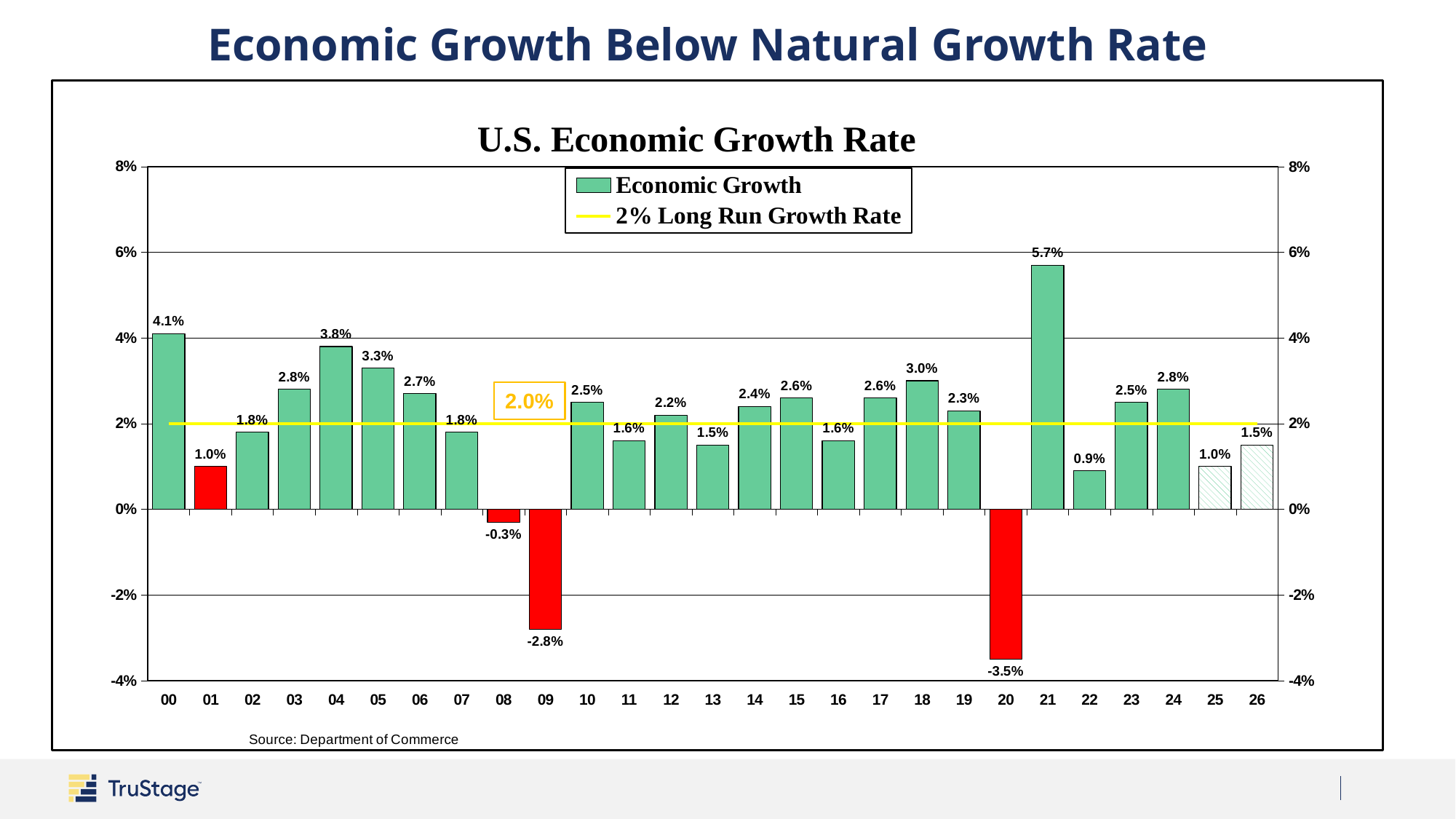
Which year has the highest economic growth rate? 21 How many entries does the legend list? 2 How many years are shown on the x axis? 27 What is the economic growth rate shown for 2026? 1.5% Which year has a higher economic growth rate, 2004 or 2018? 04 What is the difference between the economic growth rate in 2000 and in 2001? 3.1% What is the economic growth rate shown for 2009? -2.8% What kind of chart is used to show the economic growth rate? bar chart What is the economic growth rate shown for 2021? 5.7% Is the economic growth rate for 2021 greater or less than 4%? greater What is the title of the chart? U.S. Economic Growth Rate Which year has the lowest economic growth rate? 20